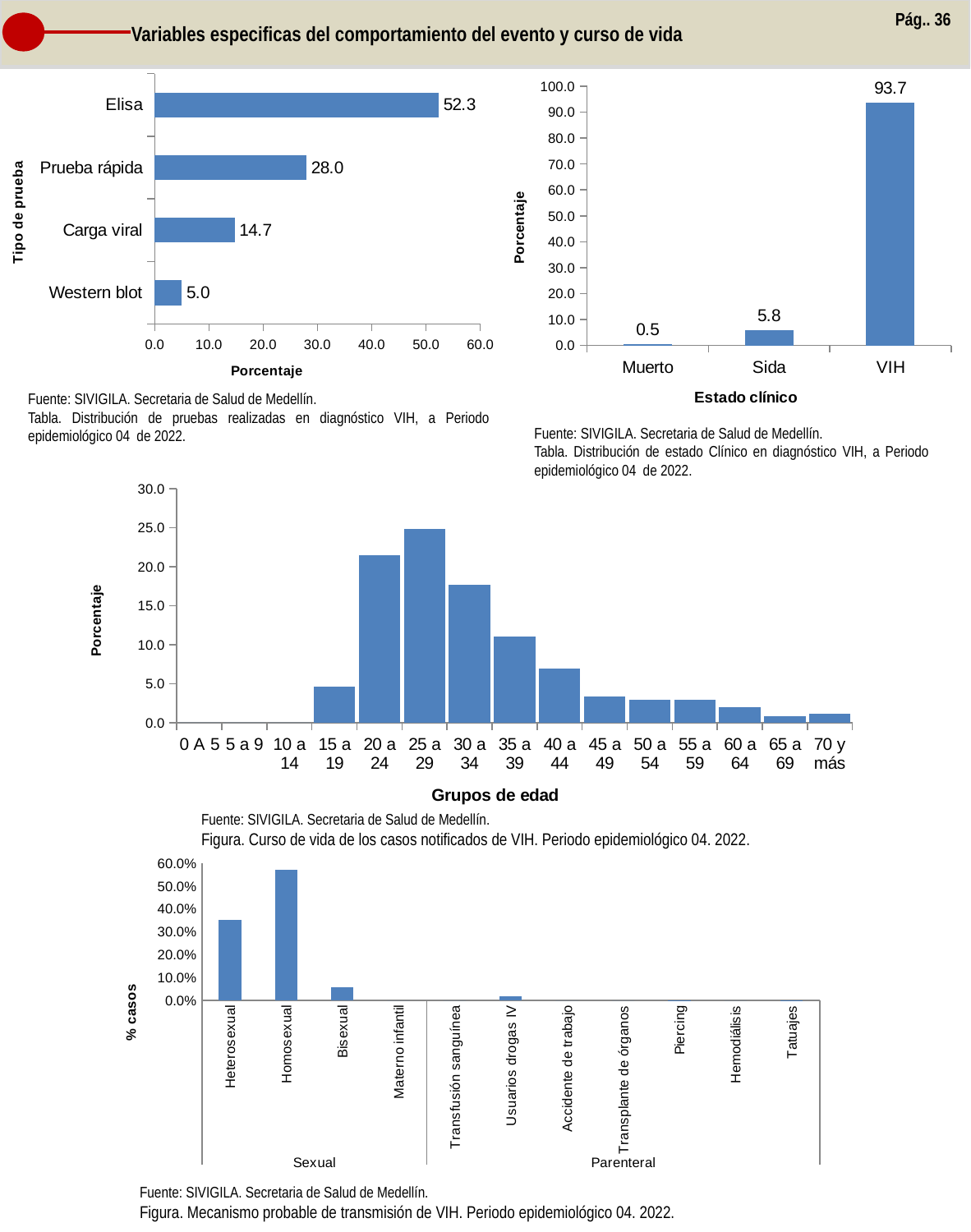
In the top-right chart (Estado clínico), what is the value for Sida? 5.8 In the middle chart (Grupos de edad), which age group has the highest percentage? 25 a 29 In the top-left chart (Tipo de prueba), what is the difference between Elisa and Prueba rápida? 24.3 In the bottom chart (Mecanismo probable de transmisión), which mechanism has the highest percentage of cases? Homosexual In the top-right chart (Estado clínico), which clinical state has the highest value? VIH In the top-right chart (Estado clínico), what is the difference between VIH and Muerto? 93.2 In the top-left chart (Tipo de prueba), what is the value for Elisa? 52.3 In the middle chart (Grupos de edad), how many age groups are shown on the x axis? 15 In the top-left chart (Tipo de prueba), how many test types are shown? 4 In the middle chart (Grupos de edad), is the value for 20 a 24 greater or less than 20.0? greater In the top-left chart (Tipo de prueba), what is the value for Carga viral? 14.7 In the top-left chart (Tipo de prueba), which test type has the lowest value? Western blot